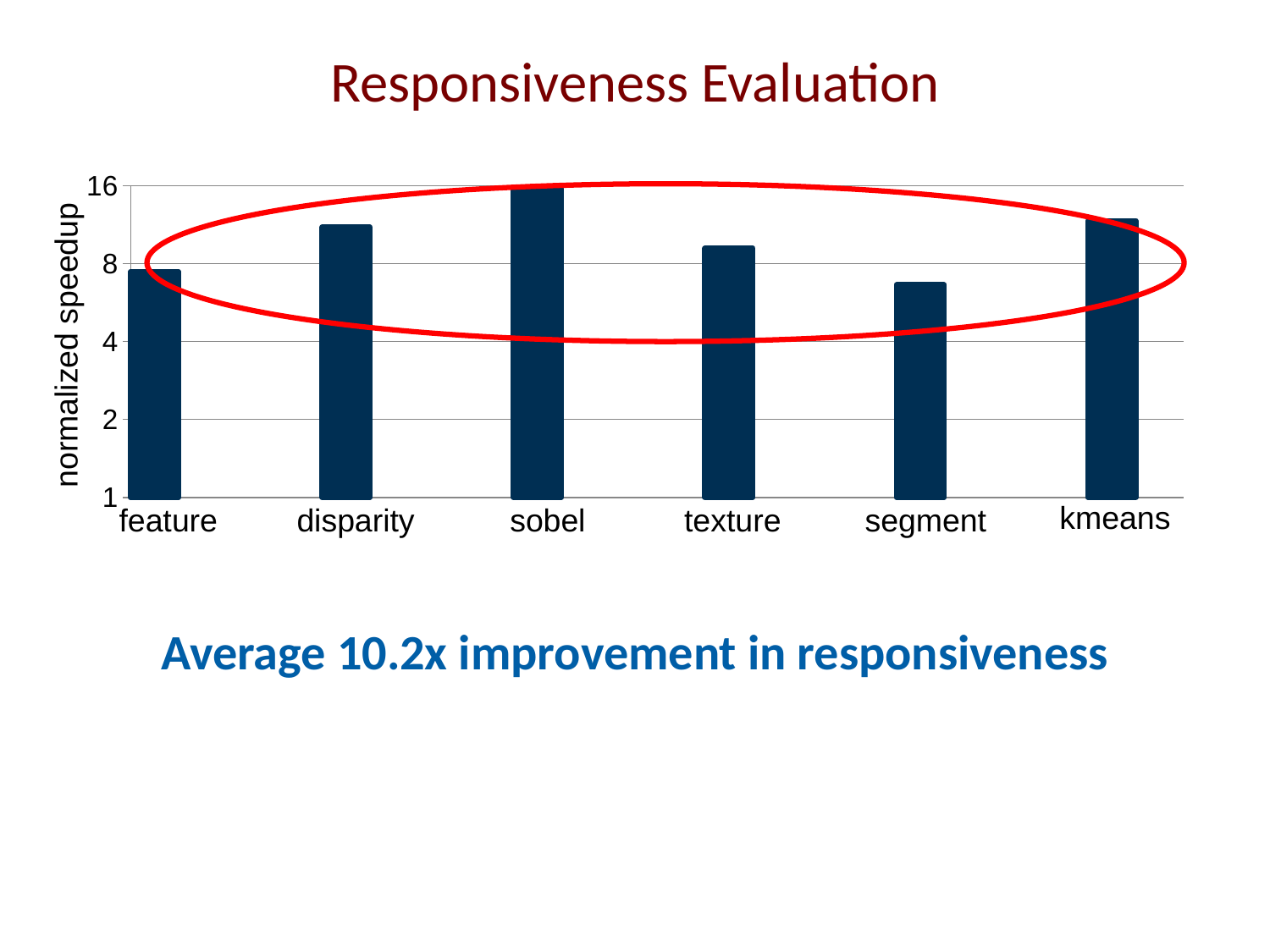
Is the value for texture greater or less than 8? greater Which has a higher normalized speedup, sobel or kmeans? sobel Is the value for disparity greater or less than 8? greater How many categories are plotted on the x axis of the chart? 6 What is the label on the y axis of the chart? normalized speedup Is the value for segment greater or less than 8? less Which has a higher normalized speedup, disparity or texture? disparity What kind of chart is shown on the slide? bar chart Which category has the lowest normalized speedup? segment Which category has the highest normalized speedup? sobel What is the title of the chart on the slide? Responsiveness Evaluation